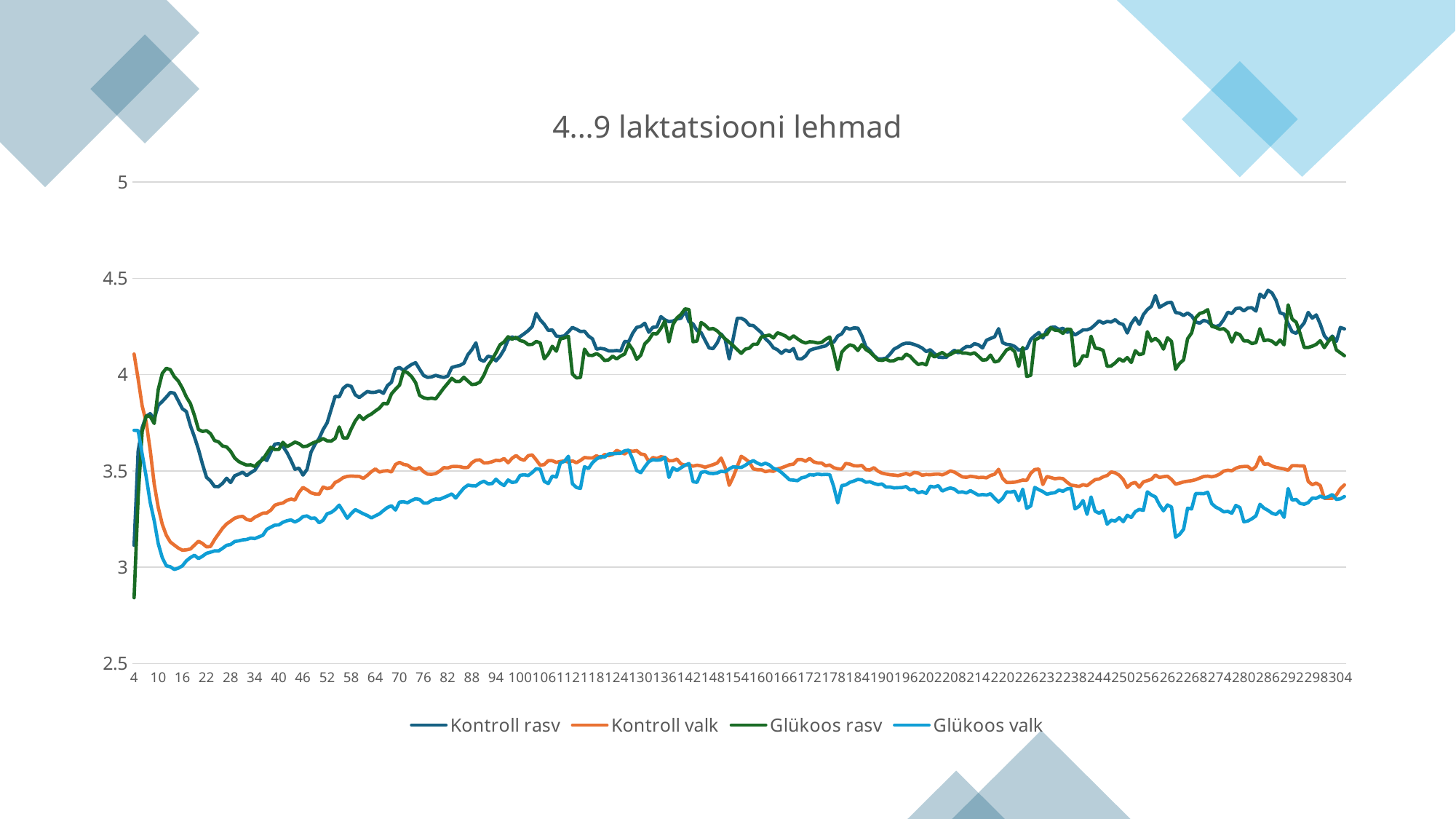
Does the Kontroll valk line rise or fall between x = 4 and x = 16? fall What is the title of the chart? 4...9 laktatsiooni lehmad Is the value of Kontroll rasv at x = 304 greater or less than 4? greater Is the value of Glükoos valk at x = 16 greater or less than 3.5? less Does the Glükoos valk line rise or fall between x = 16 and x = 124? rise How many series does the legend list? 4 Is the value of Glükoos rasv at x = 4 greater or less than 3? less At x = 262, which is higher: Kontroll valk or Glükoos valk? Kontroll valk Which series is drawn in orange? Kontroll valk What kind of chart is shown on the slide? line chart